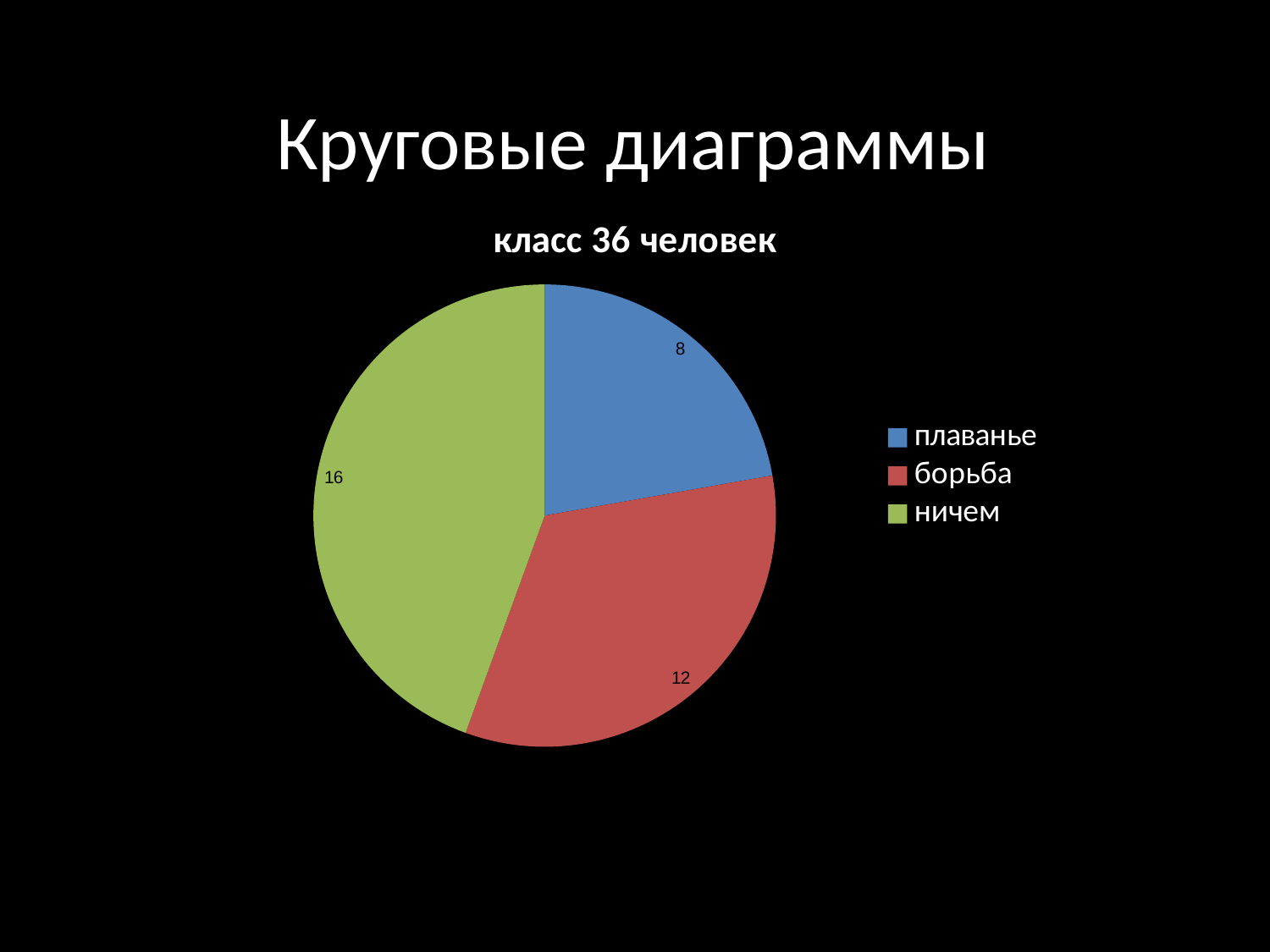
How many slices does the pie chart have? 3 Which is larger, the value for борьба or the value for плаванье? борьба What type of chart is shown on the slide? pie chart Which category has the smallest slice? плаванье What is the value for ничем? 16 What is the value for борьба? 12 What is the difference between the values for ничем and плаванье? 8 What is the value for плаванье? 8 Which colour represents борьба in the legend? red Which category has the largest slice? ничем What is the title of the chart? класс 36 человек